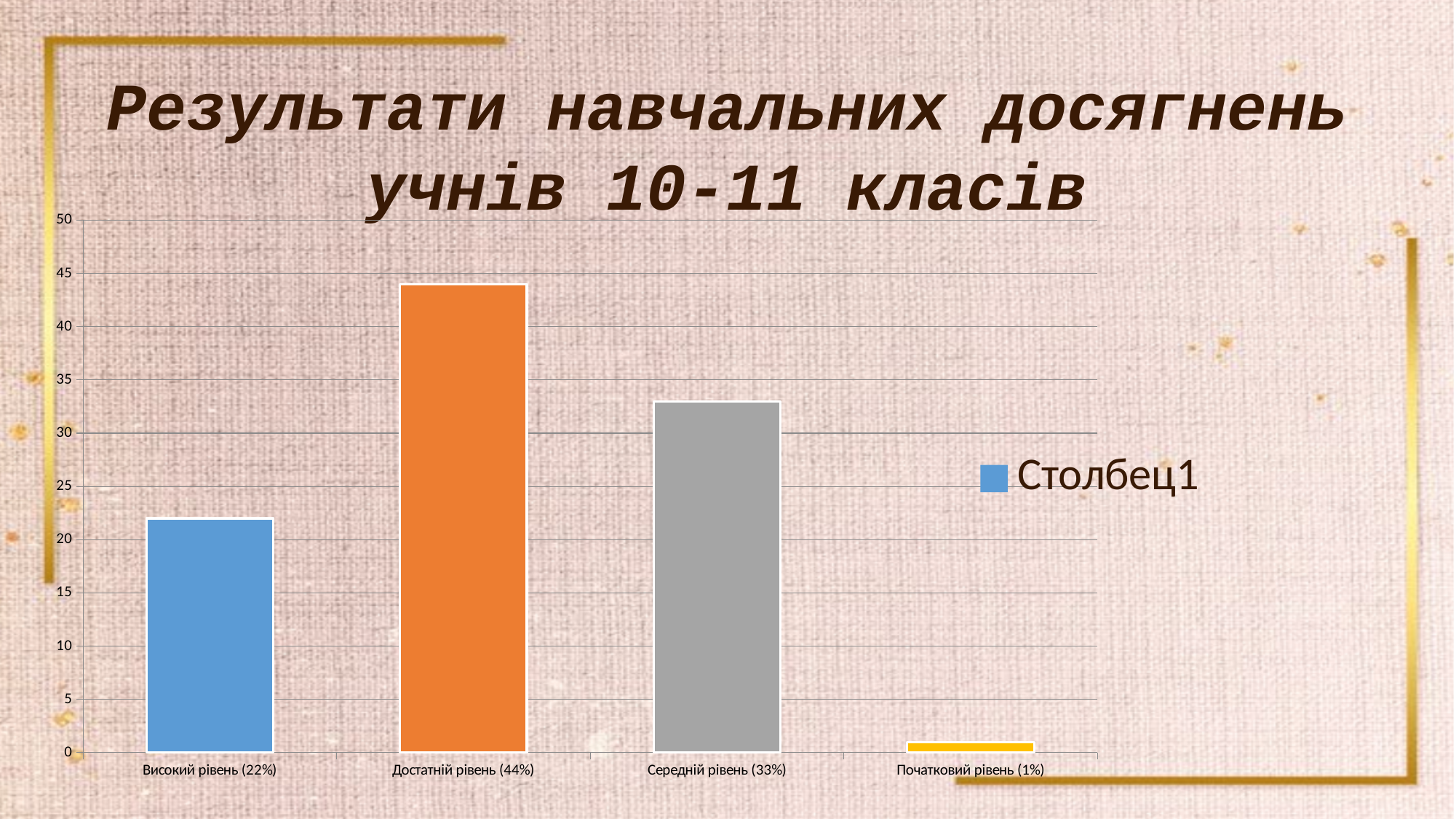
Which category has the highest bar? Достатній рівень (44%) Is the value for Достатній рівень greater or less than 40? greater What percentage is shown for Достатній рівень? 44% What is the difference between the values for Достатній рівень and Середній рівень? 11% Which is larger, the value for Високий рівень or the value for Середній рівень? Середній рівень What percentage is shown for Початковий рівень? 1% How many categories are plotted in the chart? 4 How many series does the legend list? 1 What percentage is shown for Високий рівень? 22% What kind of chart is shown on the slide? bar chart Which category has the lowest bar? Початковий рівень (1%) What is the legend entry for the series in the chart? Столбец1